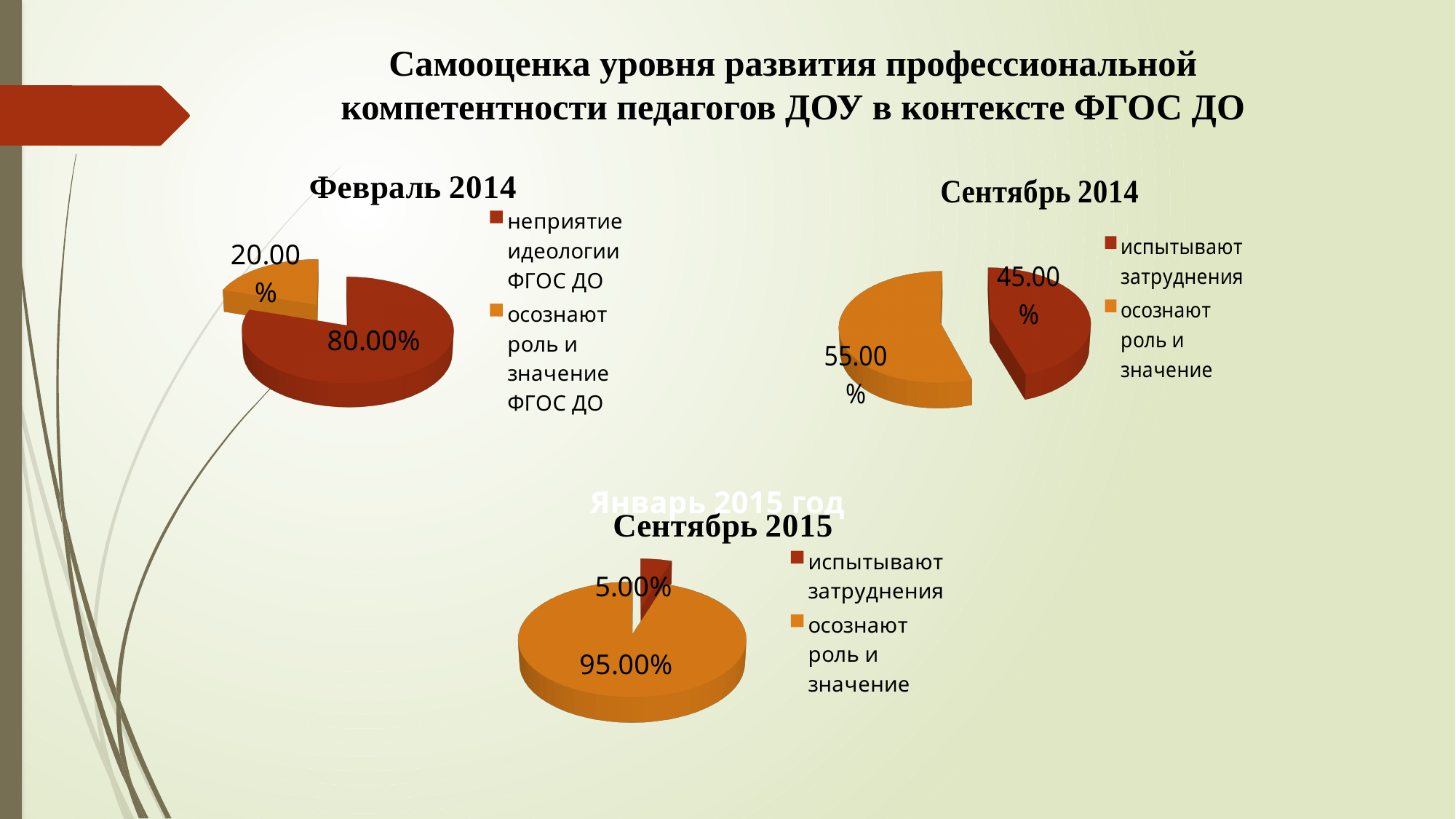
How many pie charts are shown on the slide? 3 In the bottom chart ("Сентябрь 2015"), what is the value for "осознают роль и значение"? 95.00% In the "Февраль 2014" chart, what is the value for "осознают роль и значение ФГОС ДО"? 20.00% In the "Сентябрь 2014" chart, what is the value for "осознают роль и значение"? 55.00% How many slices does the bottom chart ("Сентябрь 2015") have? 2 In the "Февраль 2014" chart, what is the value for "неприятие идеологии ФГОС ДО"? 80.00% In the "Сентябрь 2014" chart, which category has the larger share? осознают роль и значение What kind of chart is the "Февраль 2014" chart? Pie chart In the "Сентябрь 2014" chart, what is the difference between the "осознают роль и значение" and "испытывают затруднения" shares? 10.00% In the bottom chart ("Сентябрь 2015"), what is the value for "испытывают затруднения"? 5.00% In the "Сентябрь 2014" chart, what is the value for "испытывают затруднения"? 45.00% In the "Февраль 2014" chart, which category has the smaller share? осознают роль и значение ФГОС ДО